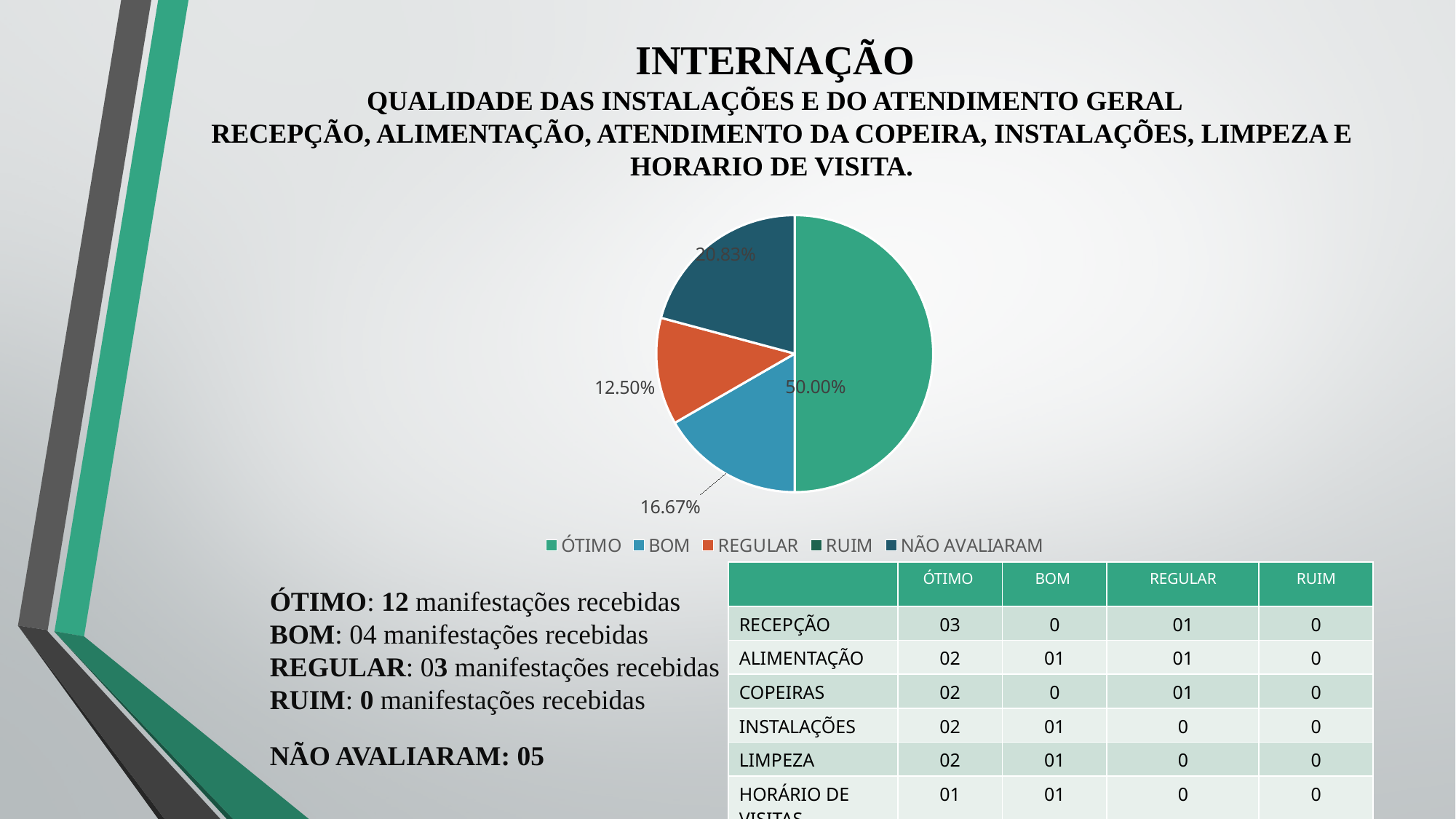
What percentage of the pie does NÃO AVALIARAM represent? 20.83% How many categories does the legend of the pie chart list? 5 What percentage of the pie does REGULAR represent? 12.50% What kind of chart is shown on the slide? pie chart What is the difference in percentage points between the ÓTIMO slice and the NÃO AVALIARAM slice? 29.17% What colour is the ÓTIMO slice in the pie chart? green What percentage of the pie does ÓTIMO represent? 50.00% How many percentage labels are shown on the pie chart? 4 Which category has the largest slice of the pie? ÓTIMO What is the difference in percentage points between the BOM slice and the REGULAR slice? 4.17% Which slice is larger, BOM or REGULAR? BOM What percentage of the pie does BOM represent? 16.67%